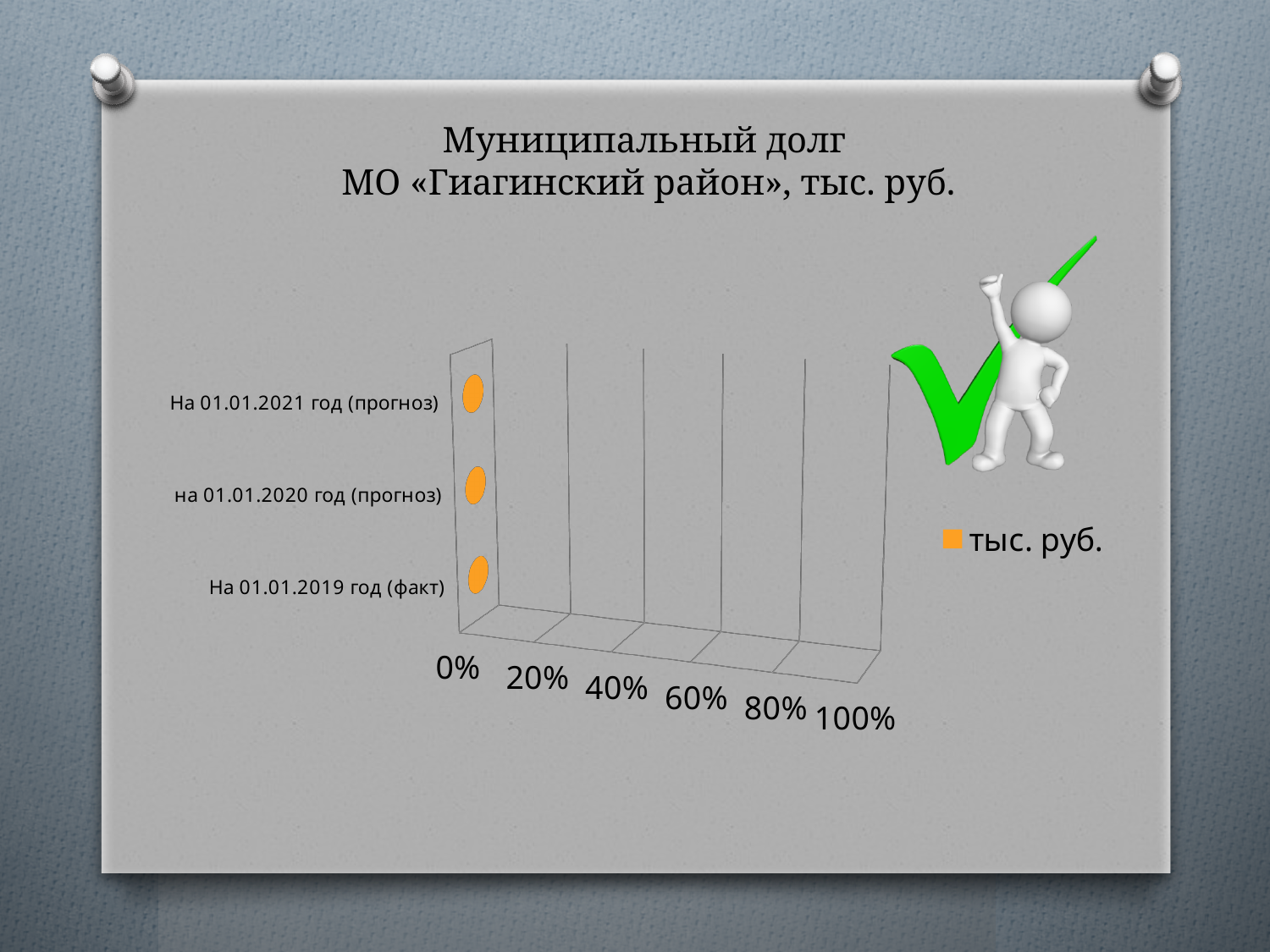
How many categories are shown on the chart? 3 What kind of chart is shown on the slide? bar chart Is the value for "на 01.01.2020 год (прогноз)" greater or less than 20%? less What is the title of the chart? Муниципальный долг МО «Гиагинский район», тыс. руб. Is the value for "На 01.01.2019 год (факт)" greater or less than 20%? less Is the value for "На 01.01.2021 год (прогноз)" greater or less than 40%? less What is the highest value shown on the horizontal axis of the chart? 100% How many series does the chart legend list? 1 What is the legend entry of the chart? тыс. руб.